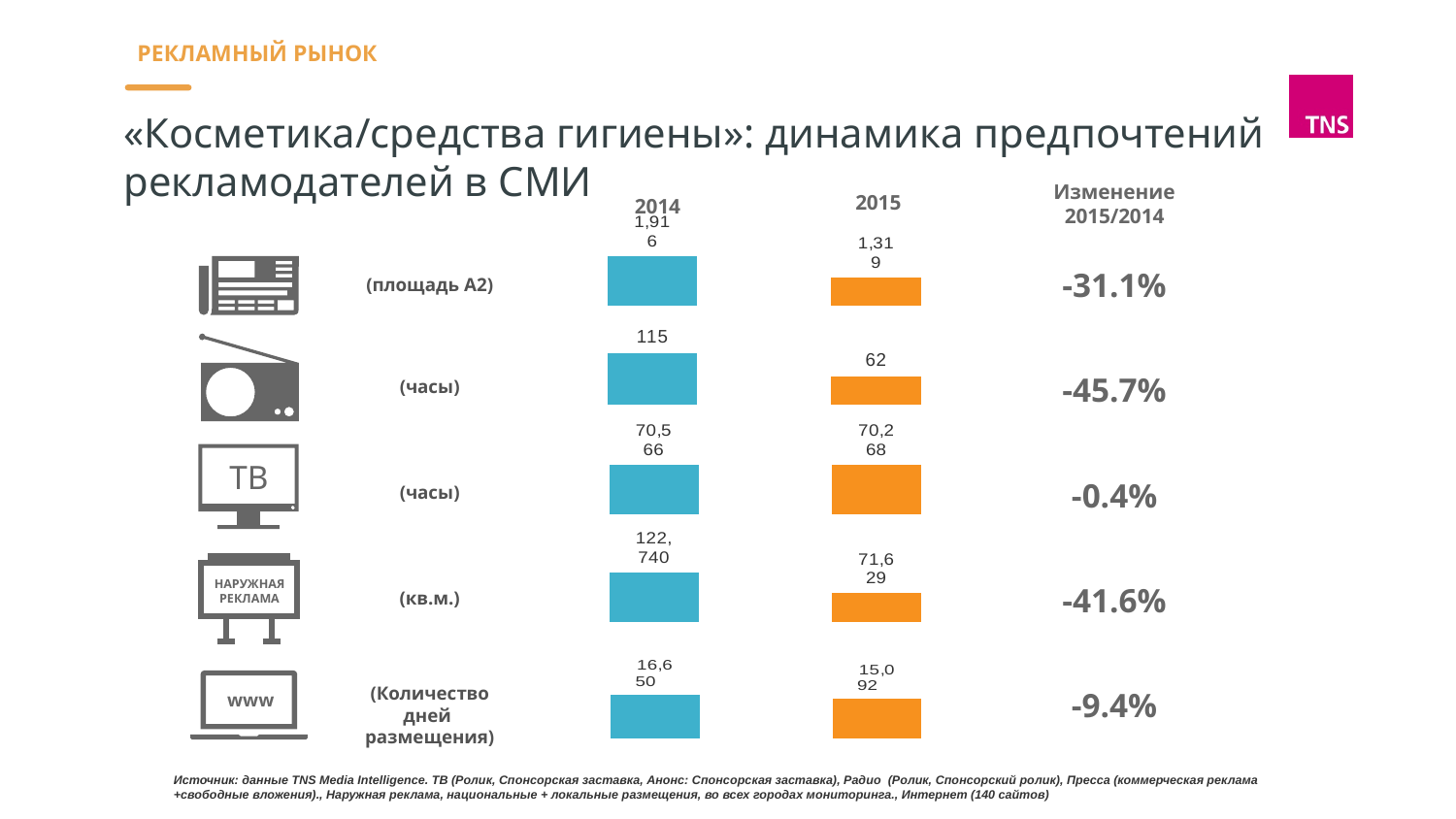
What is the 2014 value in the radio row (часы)? 115 What is the 2014 value in the top row (площадь A2)? 1,916 What is the 2015 value in the top row (площадь A2)? 1,319 What is the 2015 value in the radio row (часы)? 62 What is the change 2015/2014 shown for the radio row (часы)? -45.7% What is the 2015 value in the outdoor advertising row (кв.м.)? 71,629 What is the 2014 value in the bottom row (Количество дней размещения)? 16,650 What is the difference between the 2014 and 2015 values in the radio row (часы)? 53 What is the change 2015/2014 shown for the TV row (часы)? -0.4% In the TV row (часы), which year has the larger value, 2014 or 2015? 2014 Which row shows the largest percentage decline in the Изменение 2015/2014 column? Radio (часы), -45.7% What colour are the 2015 bars on the slide? Orange